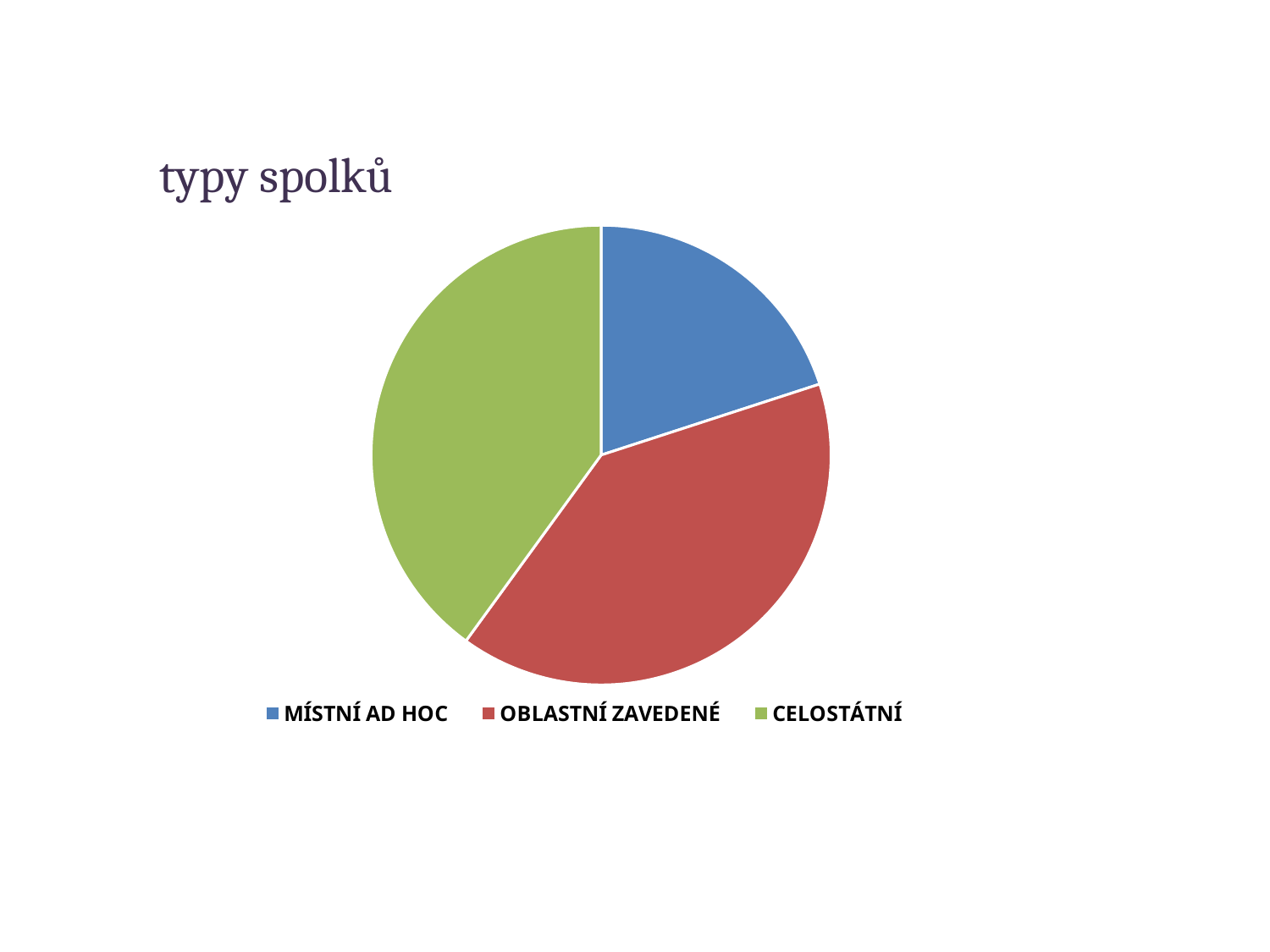
How many slices does the pie chart have? 3 Which slice is larger, MÍSTNÍ AD HOC or CELOSTÁTNÍ? CELOSTÁTNÍ What is the title of the slide containing the pie chart? typy spolků Which category has the smallest slice in the pie chart? MÍSTNÍ AD HOC What colour is the CELOSTÁTNÍ slice in the pie chart? green What kind of chart is shown on the slide? pie chart Which slice is larger, MÍSTNÍ AD HOC or OBLASTNÍ ZAVEDENÉ? OBLASTNÍ ZAVEDENÉ How many entries does the legend of the pie chart list? 3